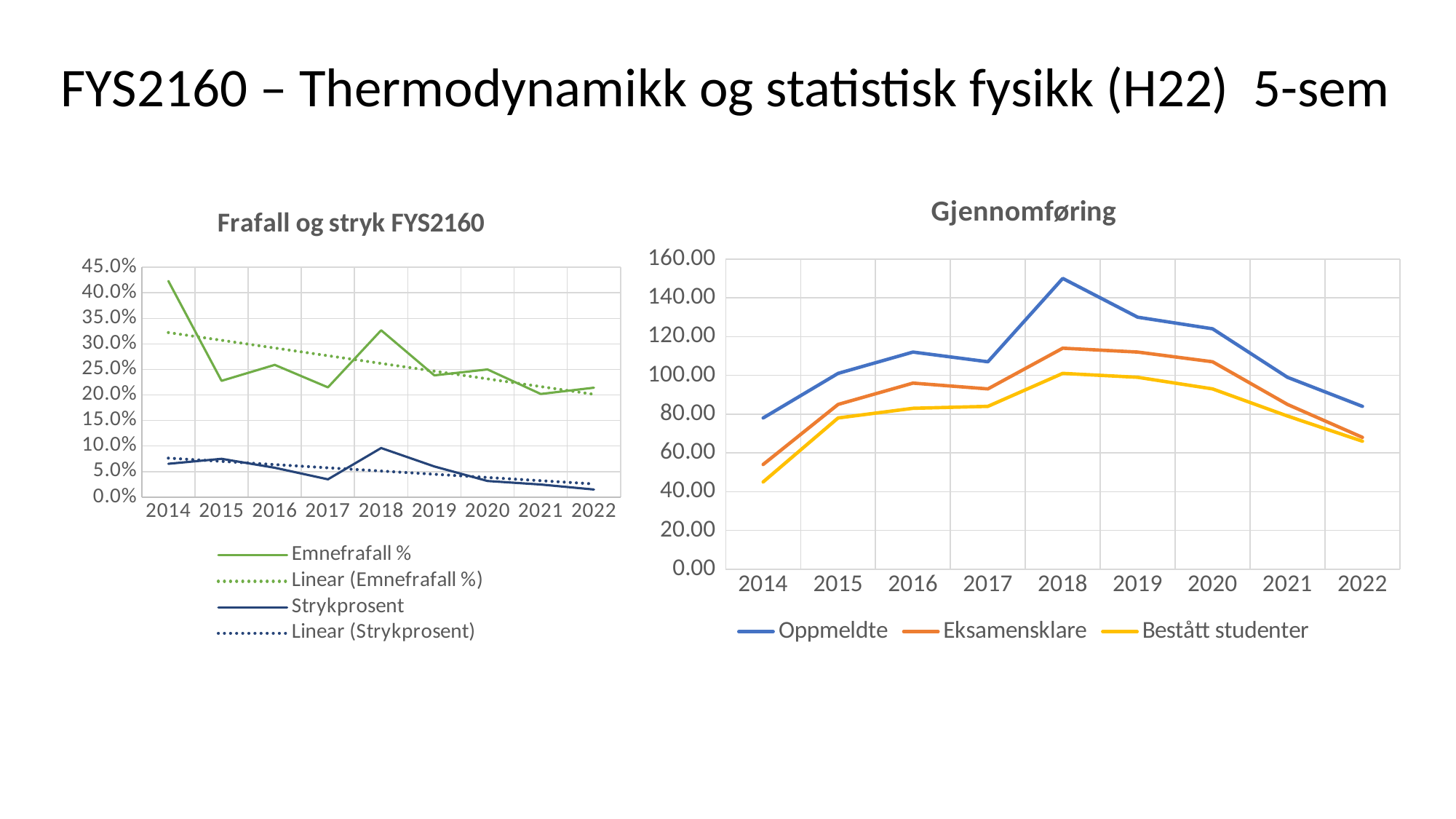
In the "Gjennomføring" chart, is the value for Bestått studenter in 2014 greater or less than 60.00? less How many entries does the legend of the "Frafall og stryk FYS2160" chart list? 4 In the "Gjennomføring" chart, in which year is Oppmeldte lowest? 2014 In the "Frafall og stryk FYS2160" chart, in which year is Emnefrafall % highest? 2014 In the "Gjennomføring" chart, is the value for Eksamensklare in 2018 greater or less than 100.00? greater How many years are shown on the x axis of the "Gjennomføring" chart? 9 In the "Gjennomføring" chart, is the value for Oppmeldte in 2018 greater or less than 140.00? greater How many series does the legend of the "Gjennomføring" chart list? 3 In the "Gjennomføring" chart, in which year is Oppmeldte highest? 2018 In the "Frafall og stryk FYS2160" chart, which series is higher in 2018, Emnefrafall % or Strykprosent? Emnefrafall % What type of chart is the "Gjennomføring" chart? line chart